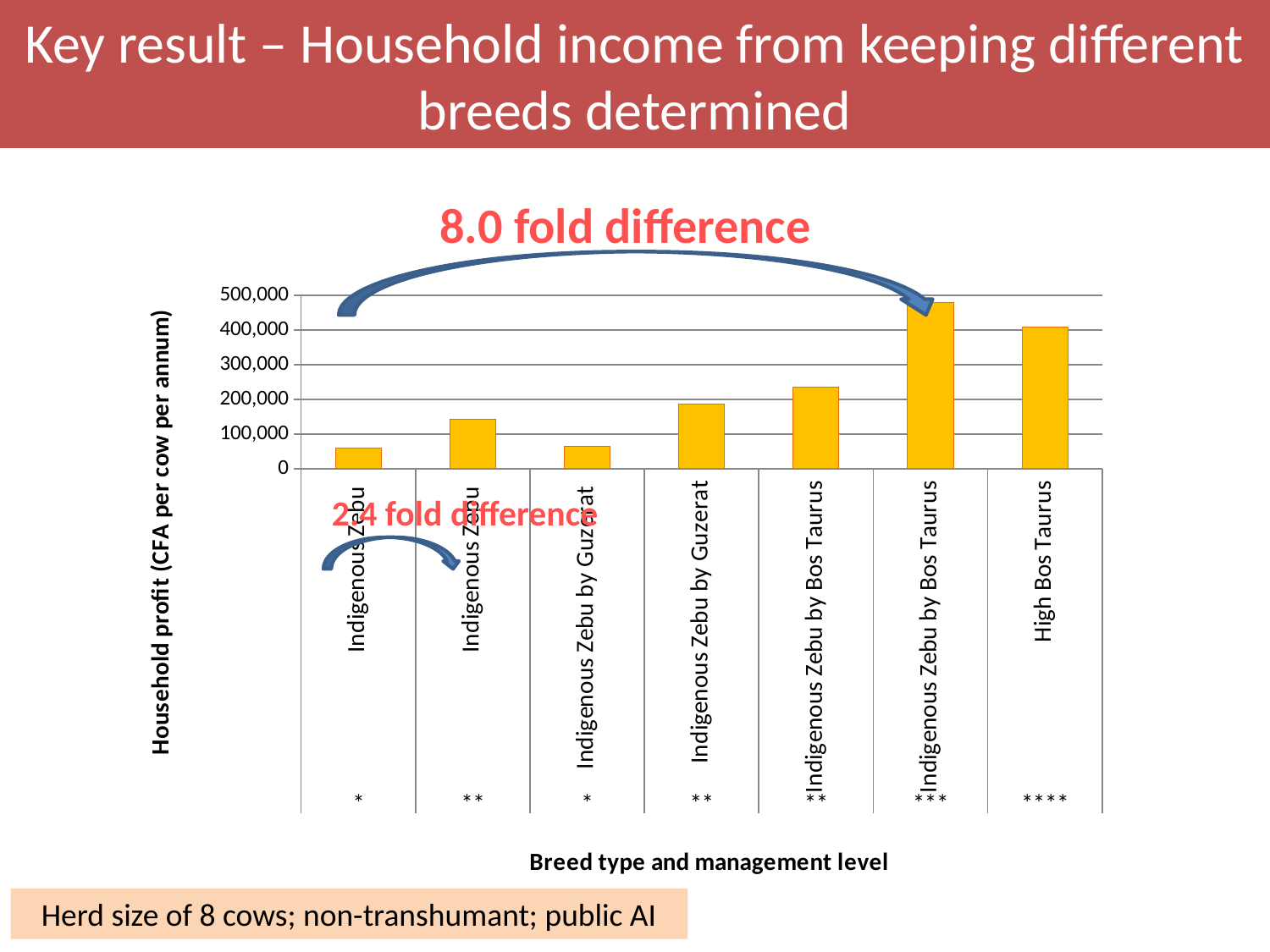
Is the household profit for Indigenous Zebu by Bos Taurus (**) greater or less than 200,000? greater Which has the larger household profit: High Bos Taurus or Indigenous Zebu by Bos Taurus (***)? Indigenous Zebu by Bos Taurus (***) Is the household profit for Indigenous Zebu by Bos Taurus (***) greater or less than 400,000? greater How many bars (breed type and management level categories) are plotted in the chart? 7 What is the title of the vertical axis of the chart? Household profit (CFA per cow per annum) What fold difference does the annotation above the chart state between the lowest and highest bars? 8.0 fold difference Which has the larger household profit: Indigenous Zebu (**) or Indigenous Zebu by Guzerat (**)? Indigenous Zebu by Guzerat (**) Is the household profit for Indigenous Zebu (**) greater or less than 200,000? less What kind of chart is shown on the slide? bar chart Which category has the highest household profit per cow per annum? Indigenous Zebu by Bos Taurus (***)